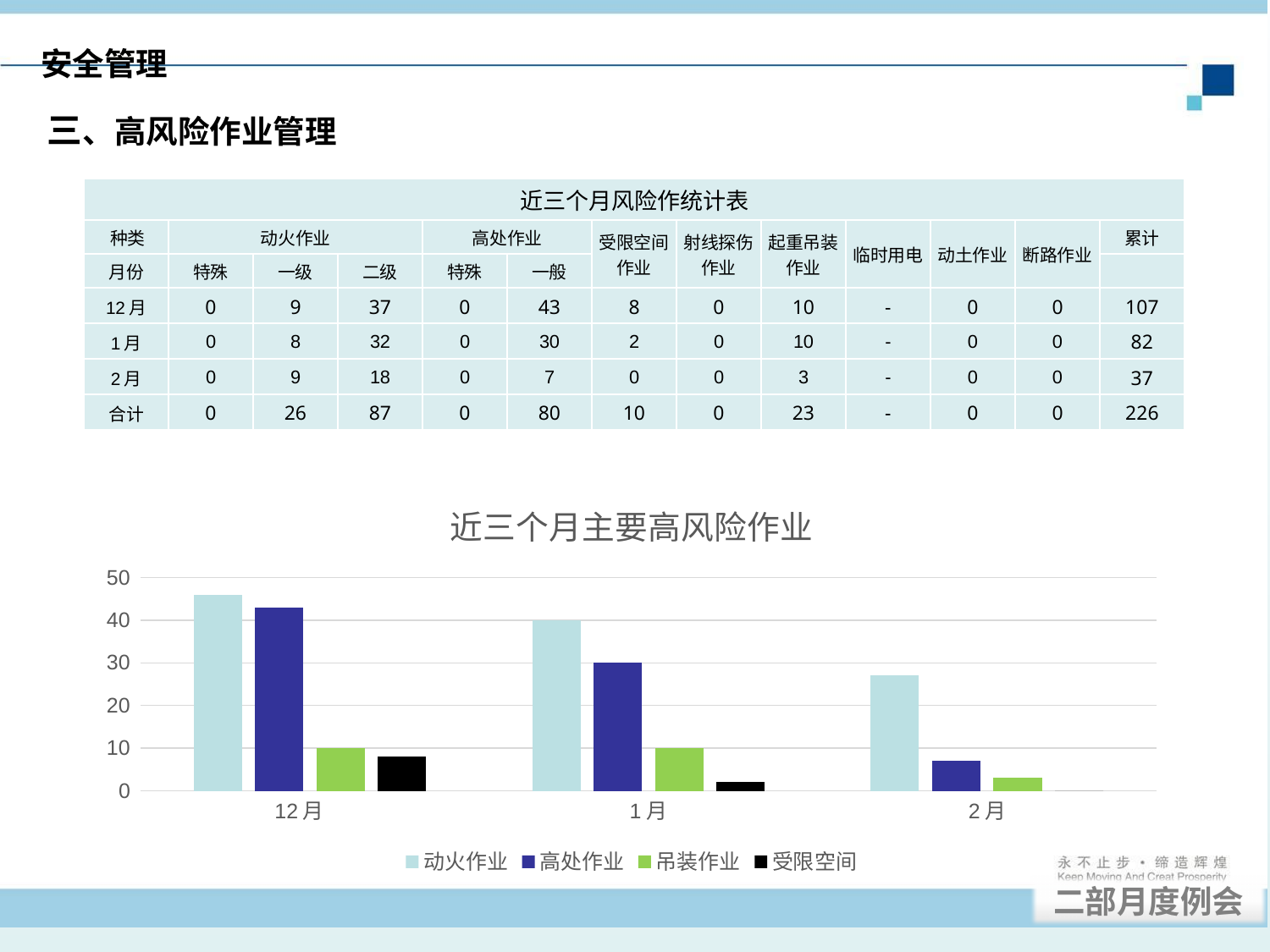
In the chart, what is the value of 动火作业 for 1月? 40 In the chart, which month has the highest 高处作业 value? 12月 In the chart, does the 高处作业 value rise or fall from 12月 to 2月? fall How many month categories are shown on the x axis of the chart? 3 Which series is shown in black in the chart? 受限空间 In the chart, which month has the lowest 动火作业 value? 2月 In the chart, what is the value of 高处作业 for 1月? 30 How many series does the chart legend list? 4 What kind of chart is shown on the slide? bar chart In the chart, is the value of 动火作业 for 2月 greater or less than 30? less In the chart, is the value of 动火作业 for 12月 greater or less than 40? greater What is the title of the chart? 近三个月主要高风险作业